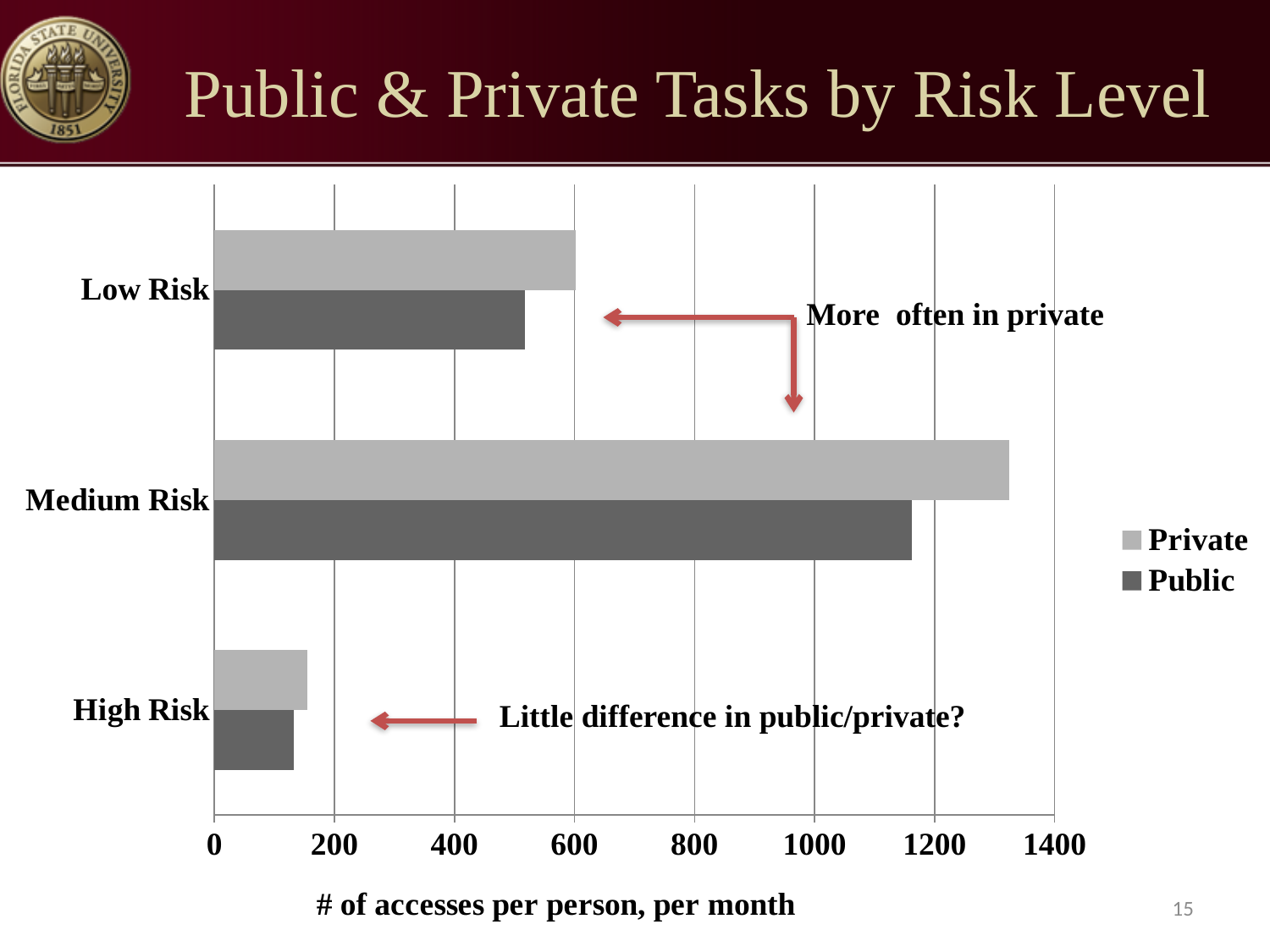
Is the Private value for Medium Risk greater or less than 1200? greater Which risk level has the highest Private value? Medium Risk What is the label on the horizontal axis of the chart? # of accesses per person, per month How many series does the legend list? 2 For Medium Risk, which is larger, the Private value or the Public value? Private What are the two entries in the chart's legend? Private and Public Is the Private value for High Risk greater or less than 200? less What kind of chart is shown on the slide? bar chart Which risk level has the lowest Public value? High Risk Is the Public value for Low Risk greater or less than 600? less For Low Risk, which is larger, the Private value or the Public value? Private How many risk-level categories are plotted on the chart? 3